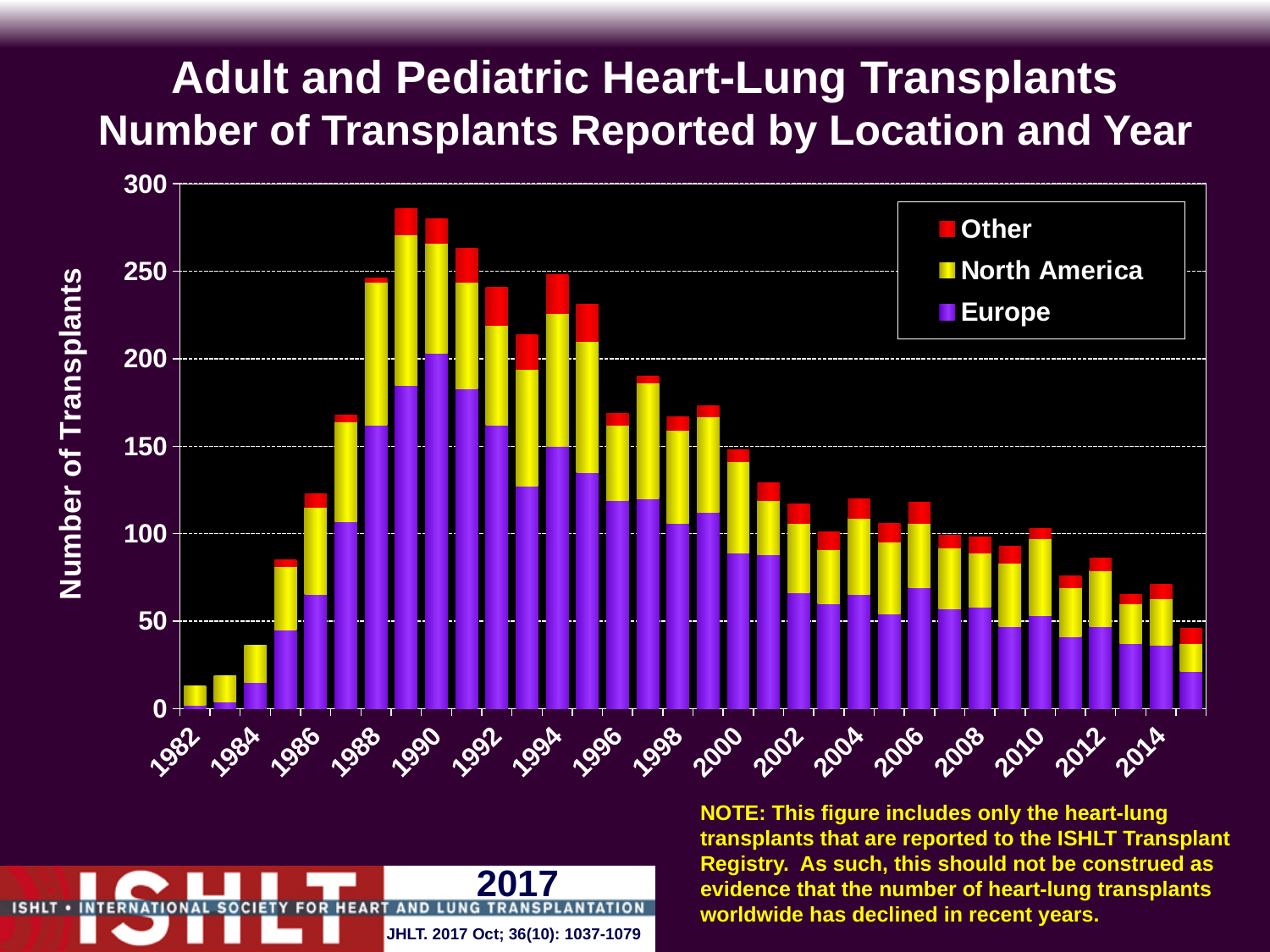
Which year has the highest total number of heart-lung transplants? 1989 Which colour represents Europe in the chart? Purple Is the total number of transplants in 1982 greater or less than 50? less Is the Europe value for 1990 greater or less than 150? greater Is the total number of transplants in 2012 greater or less than 100? less How many series does the legend list? 3 Which year has a larger total number of transplants, 1986 or 1987? 1987 What kind of chart is shown on the slide? Stacked bar chart From 1989 onward, do the total numbers of transplants generally rise or fall over the years? Fall Which year has the lowest total number of heart-lung transplants? 1982 Which series are listed in the legend? Other, North America, Europe